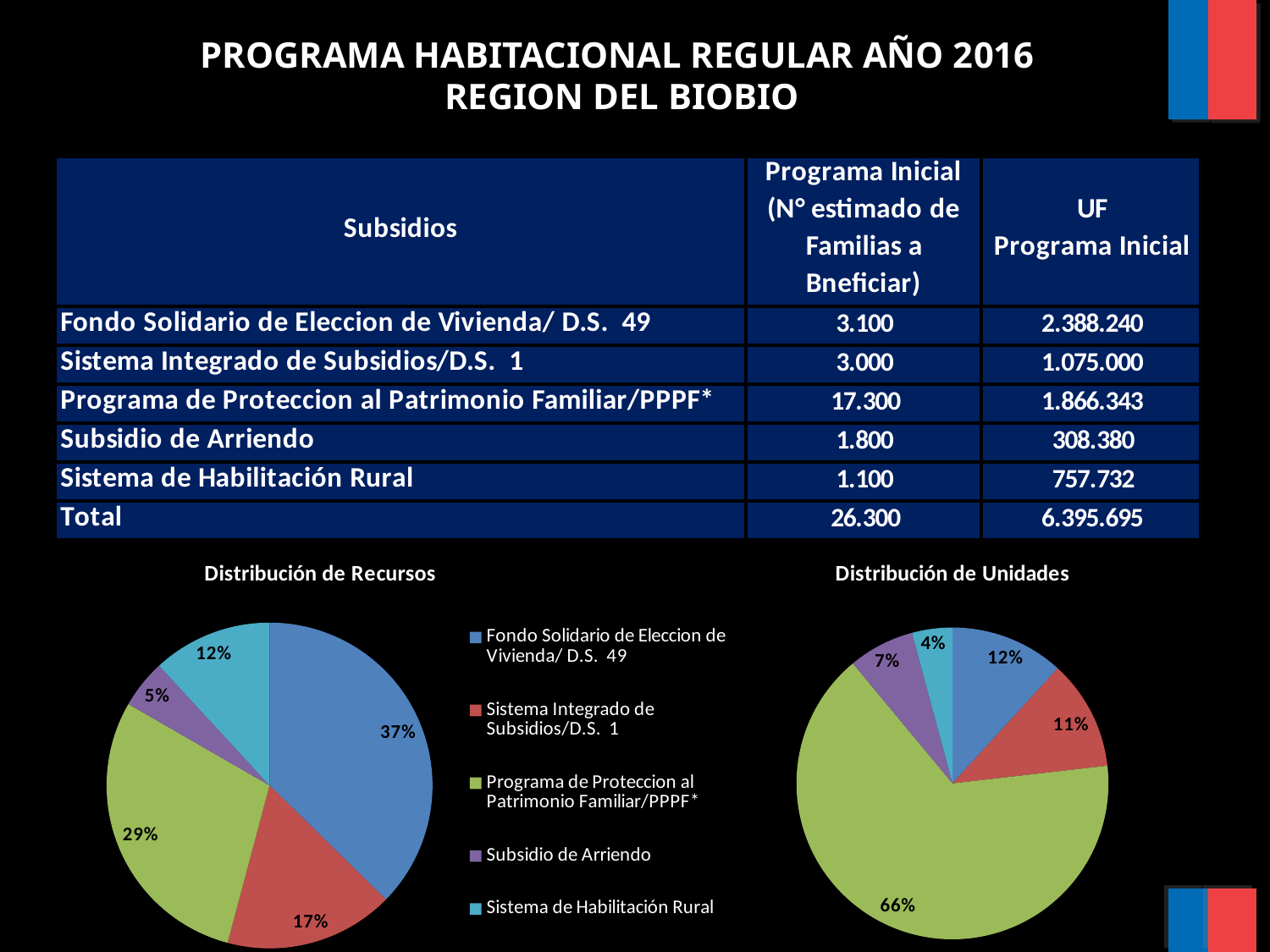
In the 'Distribución de Unidades' chart, what share does Programa de Proteccion al Patrimonio Familiar/PPPF* have? 66% What type of chart is 'Distribución de Unidades'? Pie chart In the 'Distribución de Recursos' chart, what is the difference between the shares of Fondo Solidario de Eleccion de Vivienda/ D.S. 49 and Sistema Integrado de Subsidios/D.S. 1? 20% In the 'Distribución de Recursos' chart, what share does Fondo Solidario de Eleccion de Vivienda/ D.S. 49 have? 37% In the 'Distribución de Recursos' chart, which category has the largest slice? Fondo Solidario de Eleccion de Vivienda/ D.S. 49 In the 'Distribución de Unidades' chart, what share does Sistema de Habilitación Rural have? 4% How many slices does the 'Distribución de Recursos' chart have? 5 In the 'Distribución de Unidades' chart, which category has the smallest slice? Sistema de Habilitación Rural How many entries does the legend between the two charts list? 5 In the 'Distribución de Unidades' chart, which is larger: the share of Fondo Solidario de Eleccion de Vivienda/ D.S. 49 or the share of Subsidio de Arriendo? Fondo Solidario de Eleccion de Vivienda/ D.S. 49 In the 'Distribución de Recursos' chart, which category has the smallest slice? Subsidio de Arriendo